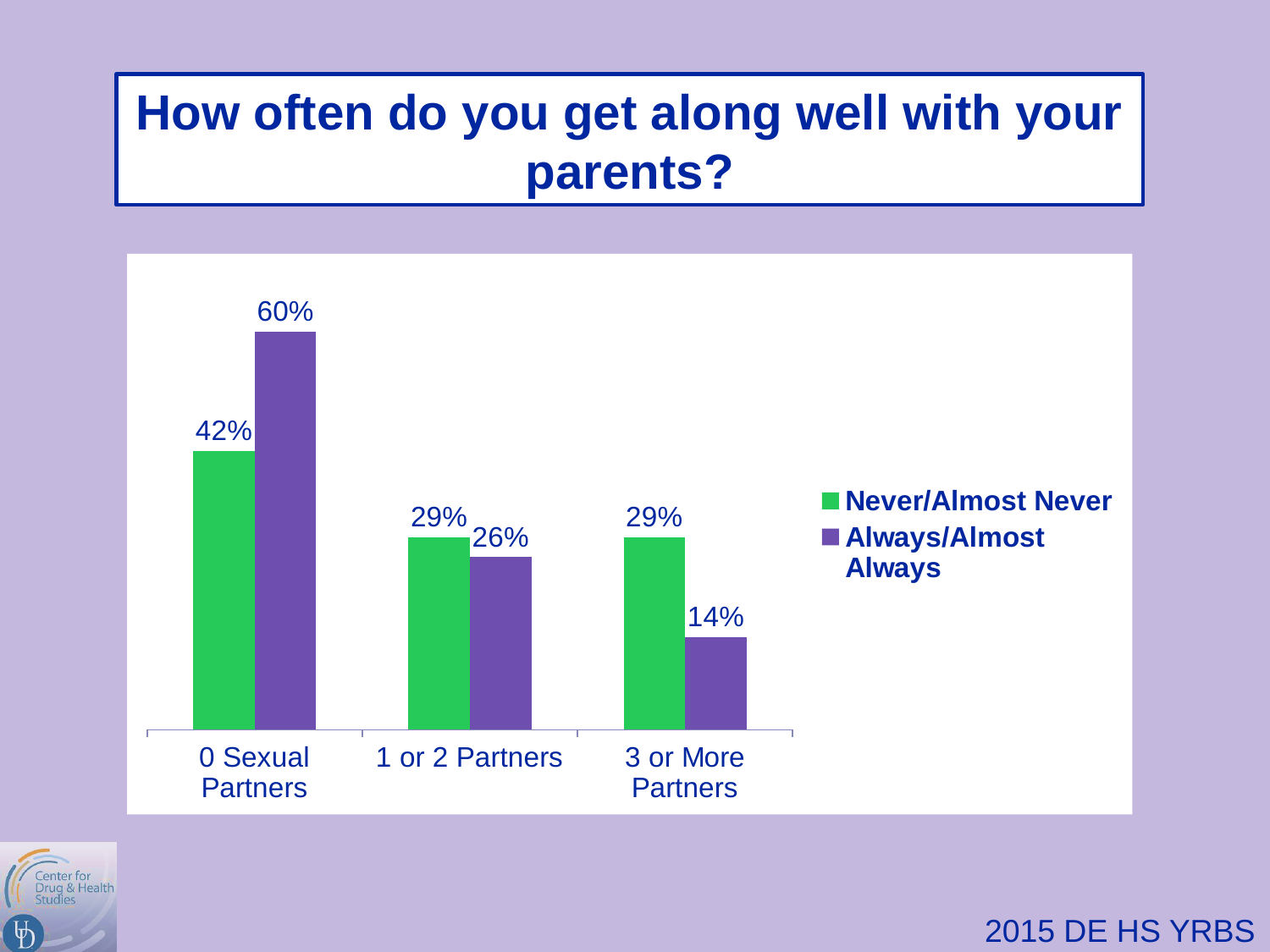
Do the Always/Almost Always values rise or fall from 0 sexual partners to 3 or more partners? Fall What kind of chart is shown on the slide? Bar chart How many categories are shown on the x axis? 3 What is the difference between the Always/Almost Always and Never/Almost Never values for 0 sexual partners? 18% What is the difference between the Never/Almost Never and Always/Almost Always values for 3 or more partners? 15% Which category has the lowest value for Always/Almost Always? 3 or More Partners Which category has the highest value for Always/Almost Always? 0 Sexual Partners For 3 or more partners, which is larger: Never/Almost Never or Always/Almost Always? Never/Almost Never How many series does the legend list? 2 What is the value for Never/Almost Never among students with 3 or more partners? 29% What is the value for Always/Almost Always among students with 0 sexual partners? 60% What is the value for Always/Almost Always among students with 1 or 2 partners? 26%